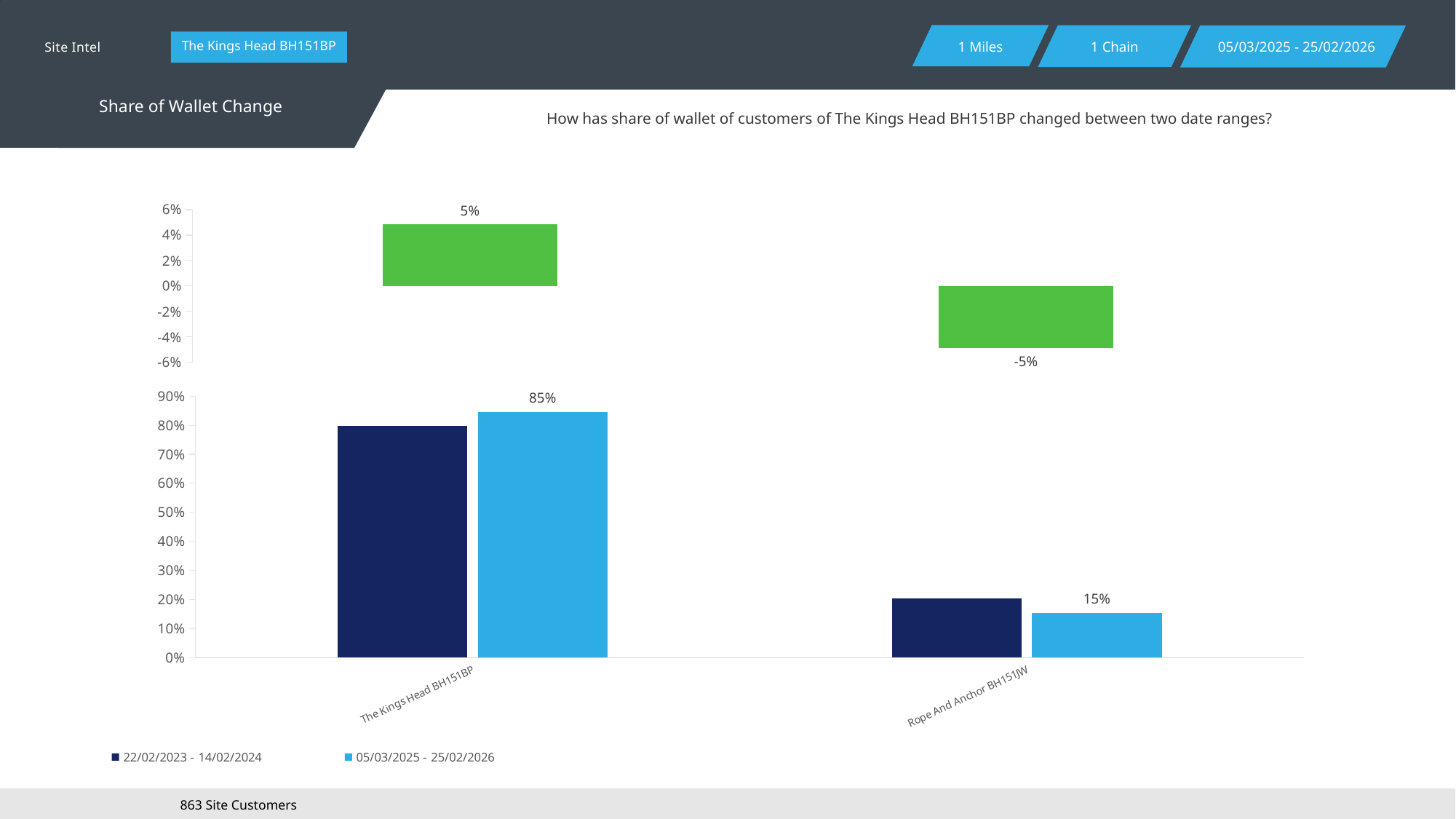
In the bottom chart, is the 22/02/2023 - 14/02/2024 value for The Kings Head BH151BP greater or less than 70%? greater In the top chart, which site has the lowest share of wallet change? Rope And Anchor BH151JW In the bottom chart, what is the share of wallet for Rope And Anchor BH151JW in the 05/03/2025 - 25/02/2026 period? 15% What kind of chart is the bottom chart? Bar chart In the bottom chart, what is the difference between the 05/03/2025 - 25/02/2026 share of wallet for The Kings Head BH151BP and Rope And Anchor BH151JW? 70% How many sites are shown on the x axis of the bottom chart? 2 In the bottom chart, is the 22/02/2023 - 14/02/2024 value for Rope And Anchor BH151JW greater or less than 30%? less In the top chart, what is the share of wallet change for The Kings Head BH151BP? 5% In the bottom chart, what is the share of wallet for The Kings Head BH151BP in the 05/03/2025 - 25/02/2026 period? 85% How many series does the legend of the bottom chart list? 2 In the top chart, what is the share of wallet change for Rope And Anchor BH151JW? -5% In the bottom chart, which site has the highest share of wallet in the 05/03/2025 - 25/02/2026 period? The Kings Head BH151BP